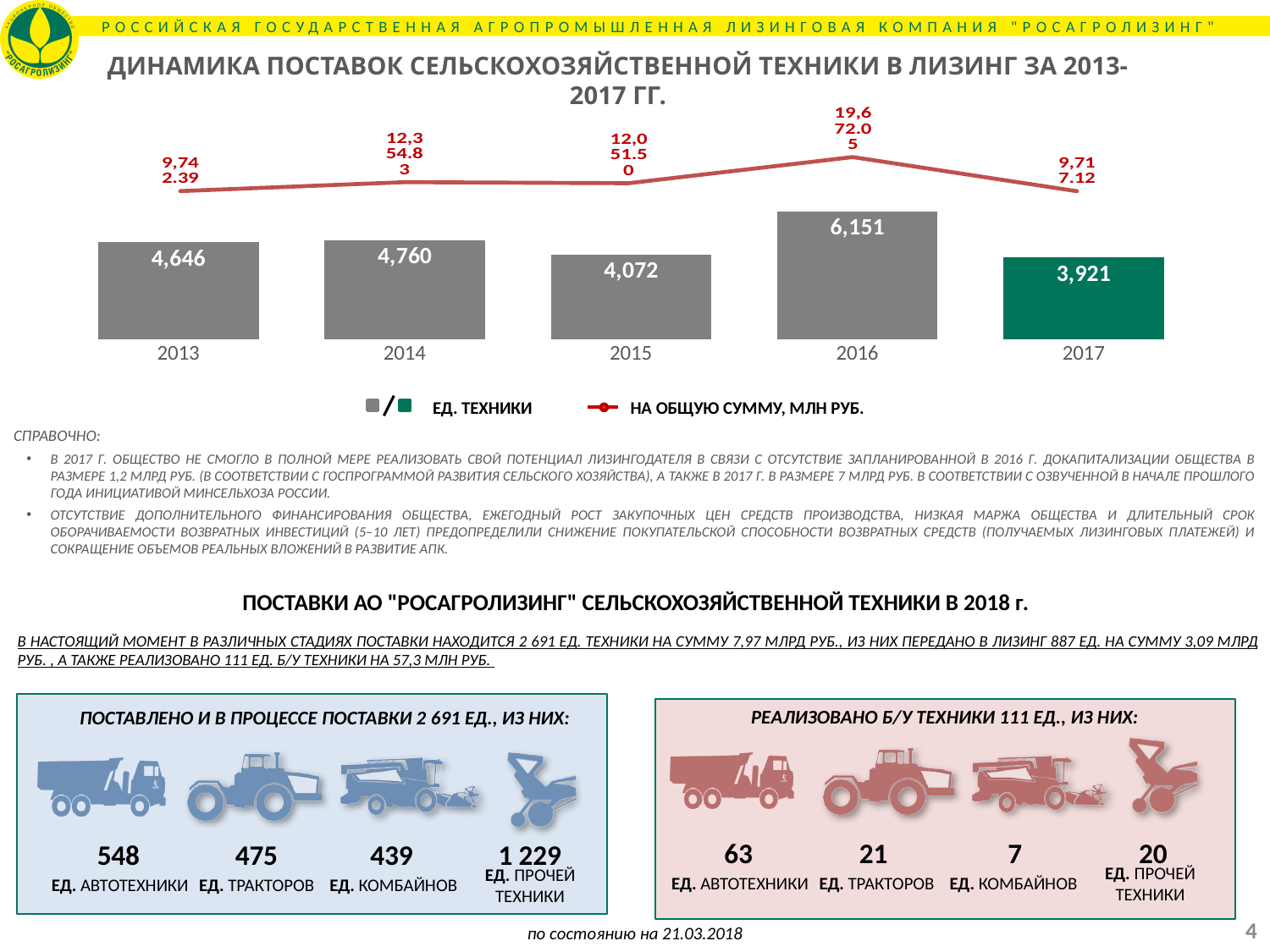
What is the difference in units of equipment between 2014 and 2013? 114 How many years are shown on the x axis of the chart? 5 What is the number of units of equipment (ЕД. ТЕХНИКИ) shown for 2013? 4,646 How many series does the chart legend list? 2 What is the number of units of equipment (ЕД. ТЕХНИКИ) shown for 2017? 3,921 Which year has the highest number of units of equipment in the bar chart? 2016 What kind of chart is used to show the supply dynamics for 2013-2017? A bar chart combined with a line chart By how many units did the number of units of equipment fall from 2016 to 2017? 2,230 What is the number of units of equipment (ЕД. ТЕХНИКИ) shown for 2016? 6,151 Which year has the lowest number of units of equipment in the bar chart? 2017 Which year has more units of equipment, 2014 or 2015? 2014 Which year does the line series 'НА ОБЩУЮ СУММУ, МЛН РУБ.' reach its peak? 2016